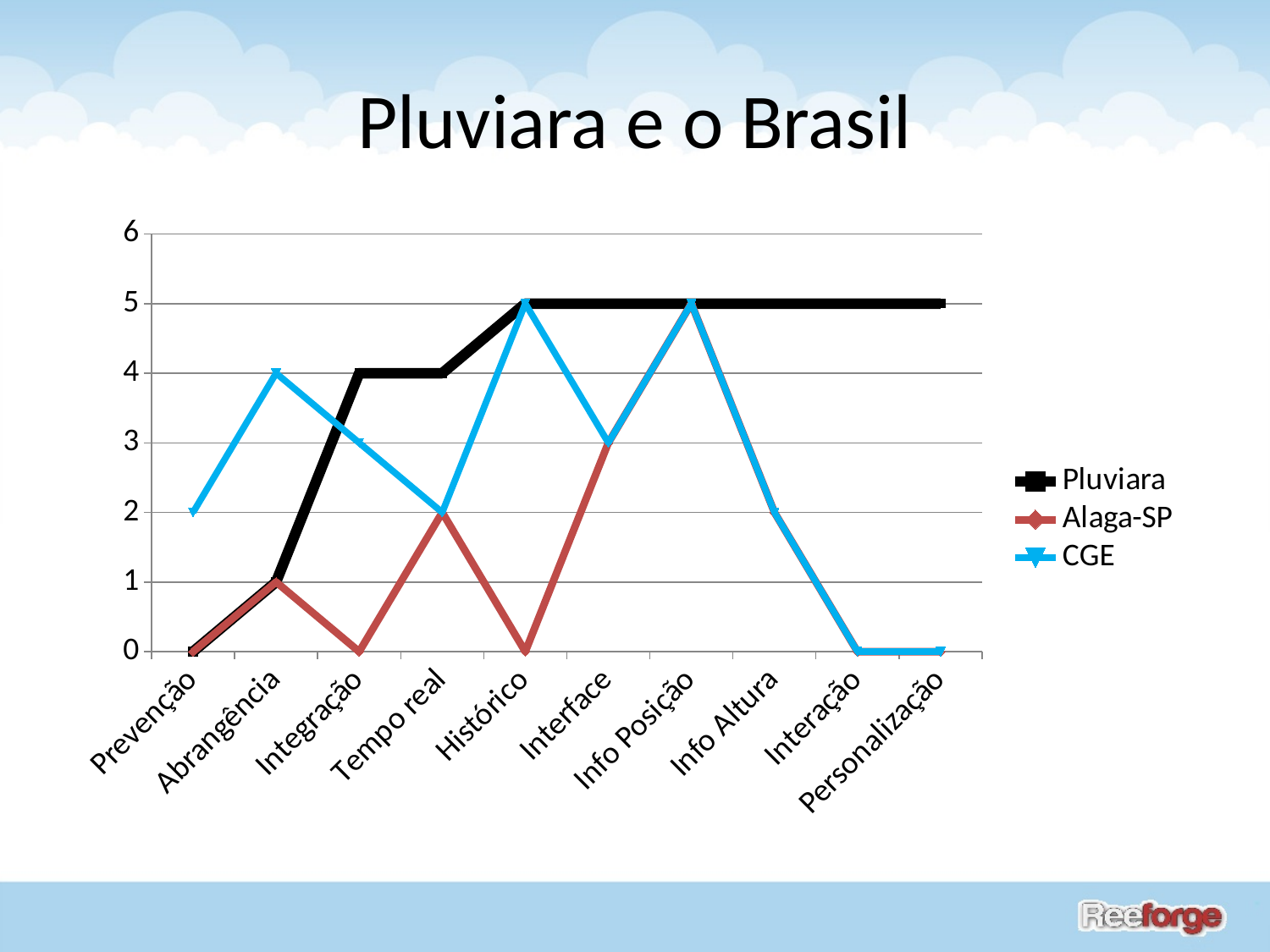
What is the title of the slide containing the chart? Pluviara e o Brasil What is the value for CGE at Abrangência? 4 What is the value for Alaga-SP at Interface? 3 Which series has the lowest value at Histórico? Alaga-SP Which series has the highest value at Tempo real? Pluviara What is the value for Pluviara at Integração? 4 Which is larger at Integração, the value for CGE or the value for Alaga-SP? CGE What is the value for CGE at Prevenção? 2 What is the difference between Pluviara and CGE at Info Altura? 3 How many series does the legend list? 3 What kind of chart is shown on the slide? line chart How many categories are shown on the x axis? 10